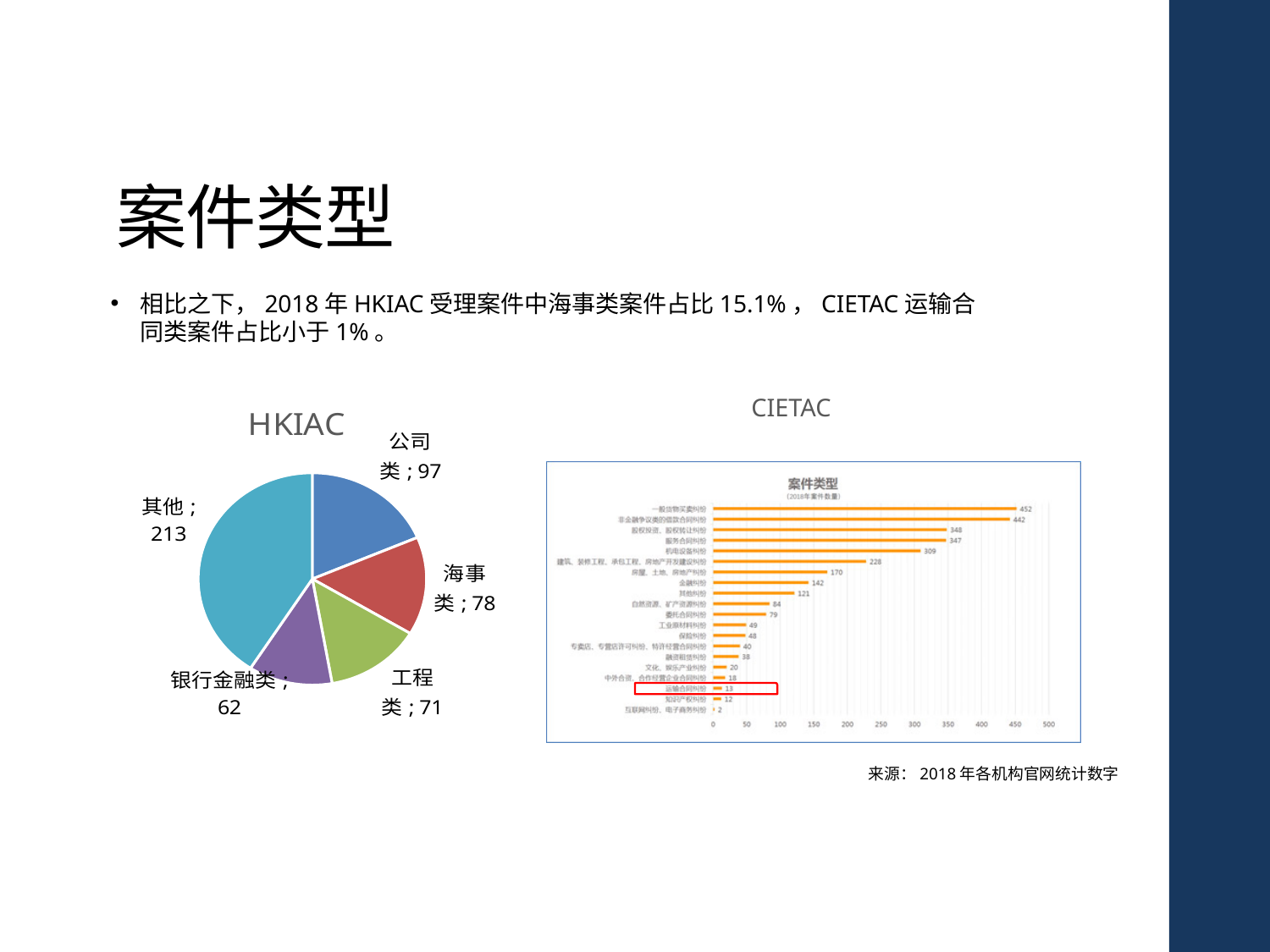
In the CIETAC chart, how many cases are shown for 运输合同纠纷 (the highlighted bar)? 13 In the HKIAC pie chart, what is the difference between the 公司类 and 工程类 values? 26 In the HKIAC pie chart, which category has the smallest number of cases? 银行金融类 In the HKIAC pie chart, how many cases are in the 海事类 category? 78 What kind of chart is the HKIAC chart? Pie chart How many categories does the HKIAC pie chart show? 5 In the HKIAC pie chart, which is larger, 公司类 or 银行金融类? 公司类 In the CIETAC chart, what is the difference between the two highest bars (452 and 442)? 10 What kind of chart is the CIETAC chart? Bar chart In the HKIAC pie chart, which category has the largest number of cases? 其他 In the CIETAC chart, what is the value of the highest bar? 452